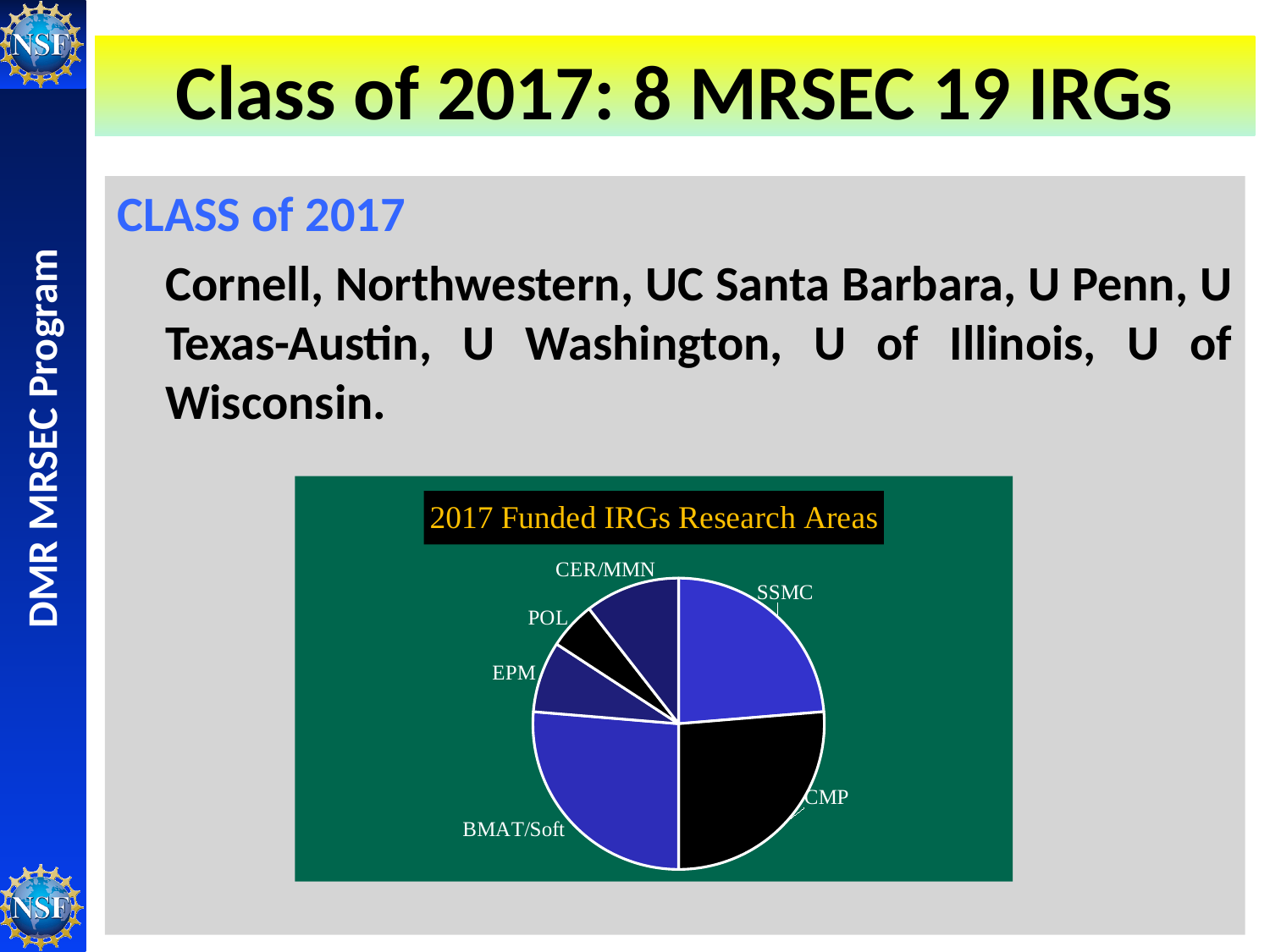
Which slice is larger, CMP or EPM? CMP Which slice is larger, BMAT/Soft or EPM? BMAT/Soft What colour is the CMP slice in the pie chart? black Which slice is larger, SSMC or CER/MMN? SSMC What is the title of the chart? 2017 Funded IRGs Research Areas How many research areas (slices) does the pie chart show? 6 What kind of chart is shown on the slide? pie chart Which research area has the smallest slice in the pie chart? POL